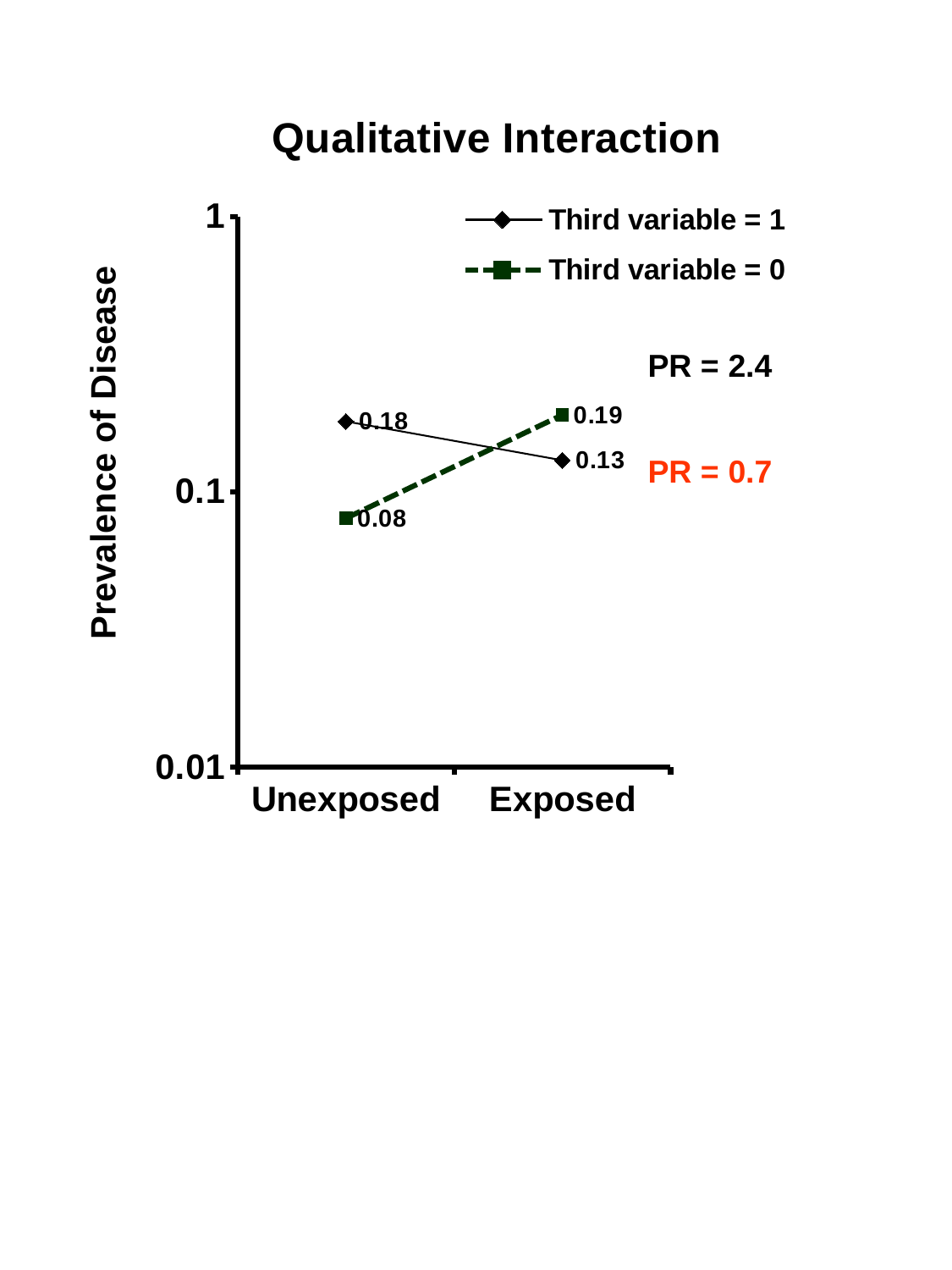
Which series has the lower prevalence in the Unexposed group? Third variable = 0 Which series has the higher prevalence in the Exposed group? Third variable = 0 What is the prevalence of disease for the Unexposed group when Third variable = 0? 0.08 How many series does the legend list? 2 What is the prevalence of disease for the Exposed group when Third variable = 1? 0.13 What type of chart is shown on the slide? line chart What is the title of the chart? Qualitative Interaction What is the difference in prevalence between Unexposed and Exposed for the Third variable = 1 series? 0.05 Does the prevalence for the Third variable = 0 series rise or fall from Unexposed to Exposed? rise What is the prevalence of disease for the Unexposed group when Third variable = 1? 0.18 What is the prevalence of disease for the Exposed group when Third variable = 0? 0.19 Does the prevalence for the Third variable = 1 series rise or fall from Unexposed to Exposed? fall